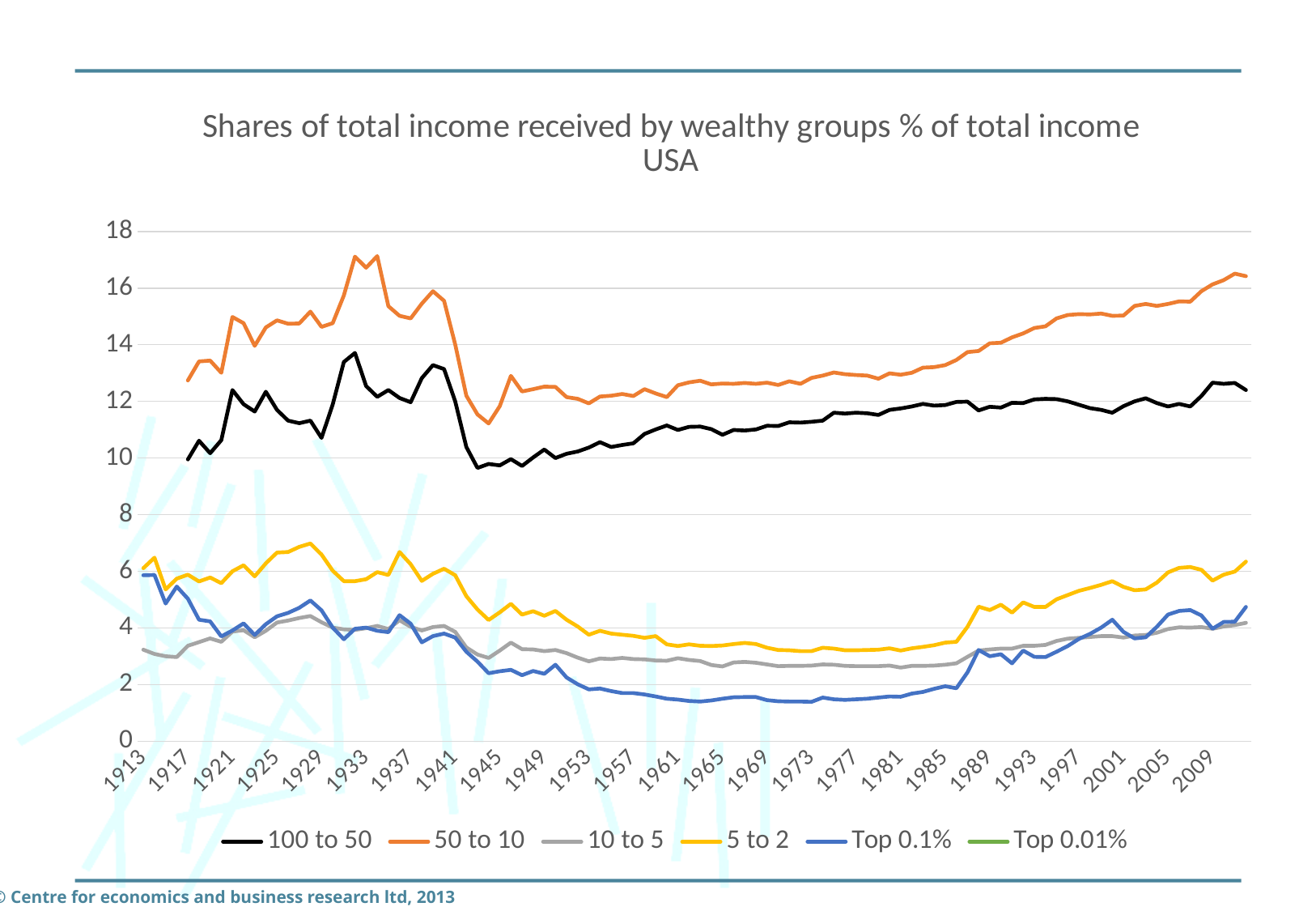
Which series has the highest values across the whole period? 50 to 10 What is the title of the chart? Shares of total income received by wealthy groups % of total income USA Is the value for the Top 0.1% series in 1973 greater or less than 2? less Is the value for the 50 to 10 series in 1933 greater or less than 16? greater Does the Top 0.1% series rise or fall between 1929 and 1973? fall Is the value for the 10 to 5 series in 1985 greater or less than 4? less In 1929, which is larger: the 5 to 2 series or the 10 to 5 series? 5 to 2 What kind of chart is shown on the slide? line chart Does the 50 to 10 series rise or fall between 1981 and 2009? rise How many series does the legend list? 6 Which series has the lowest value in 1973? Top 0.1%